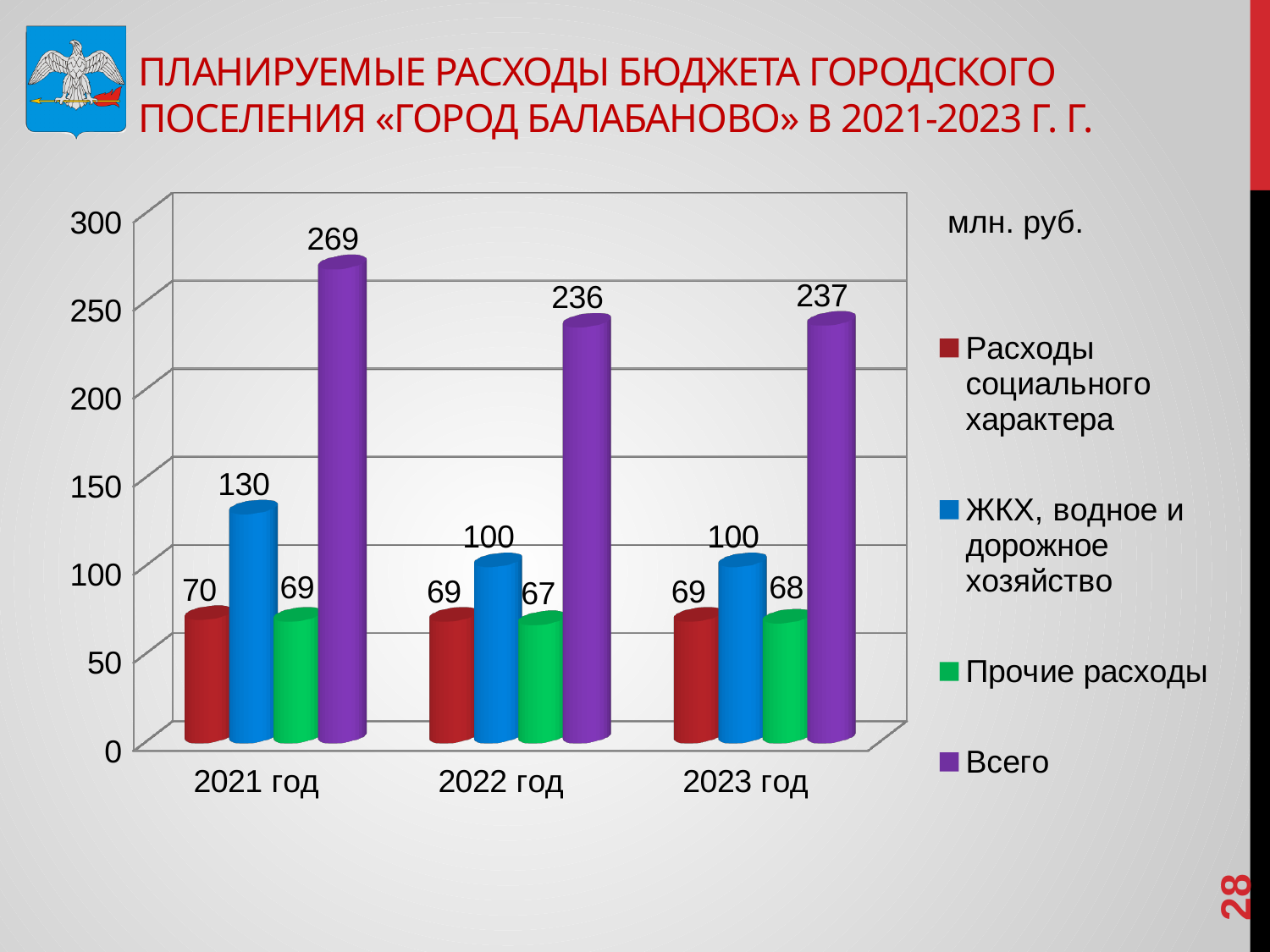
What unit is indicated next to the chart? млн. руб. In which year is the «Всего» value highest? 2021 год How many years are shown on the x axis? 3 Which is larger: «ЖКХ, водное и дорожное хозяйство» in 2021 год or in 2023 год? 2021 год What is the value of «ЖКХ, водное и дорожное хозяйство» for 2022 год? 100 What is the value of «Расходы социального характера» for 2021 год? 70 What is the difference between the «Всего» values for 2021 год and 2022 год? 33 How many series does the legend list? 4 What kind of chart is shown on the slide? Bar chart What is the value of «Прочие расходы» for 2023 год? 68 What is the value of «Всего» for 2021 год? 269